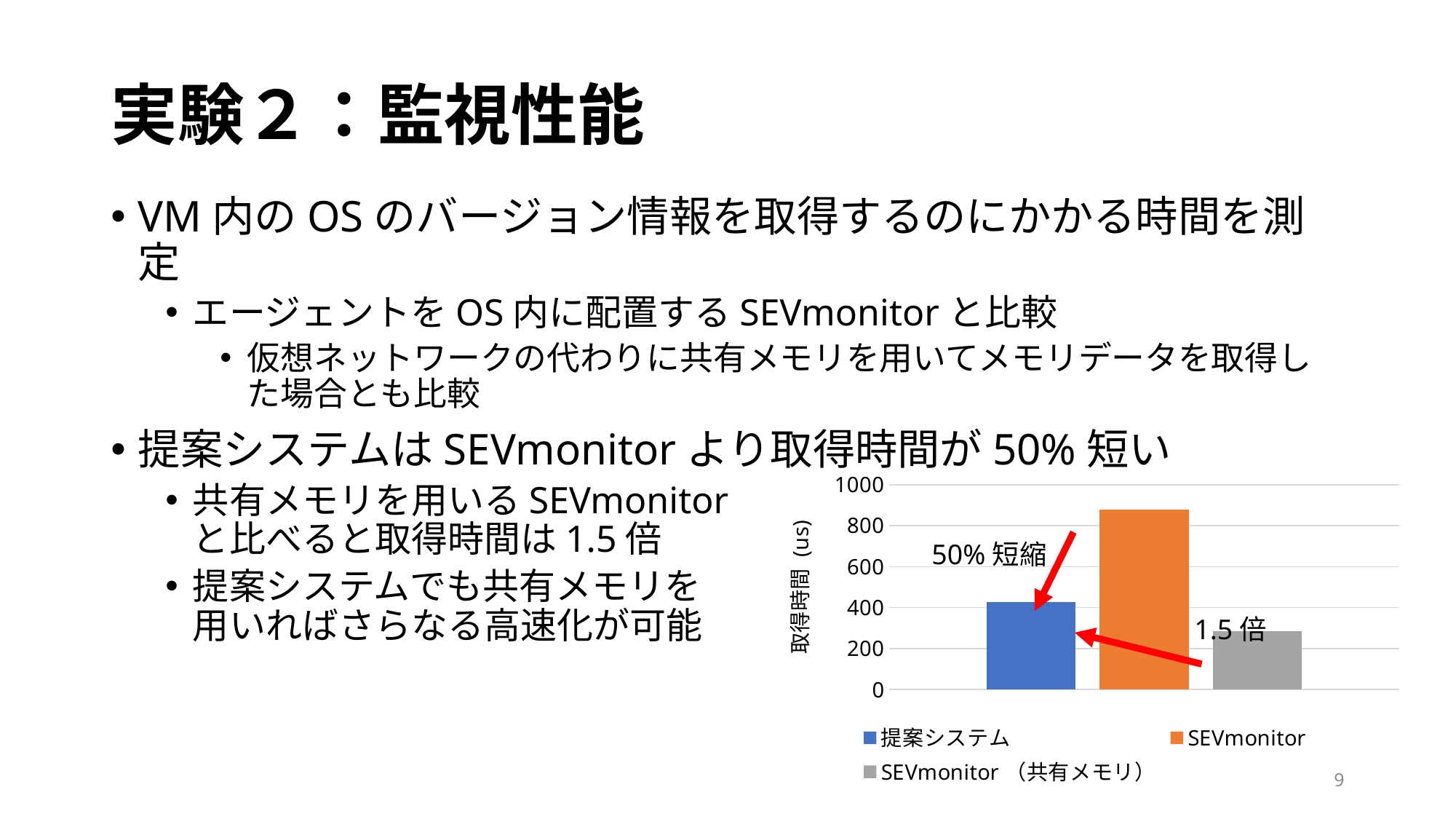
Is the value for SEVmonitor（共有メモリ）greater or less than 400? less Is the value for 提案システム greater or less than 600? less What is the label of the vertical axis of the chart? 取得時間（us） Which has a larger 取得時間, 提案システム or SEVmonitor? SEVmonitor Is the value for 提案システム greater or less than 200? greater What kind of chart is shown on the slide? bar chart How many series does the chart legend list? 3 What colour is the bar for SEVmonitor in the chart? orange Which has a larger 取得時間, 提案システム or SEVmonitor（共有メモリ）? 提案システム Which series has the highest 取得時間 in the chart? SEVmonitor Which series has the lowest 取得時間 in the chart? SEVmonitor（共有メモリ）